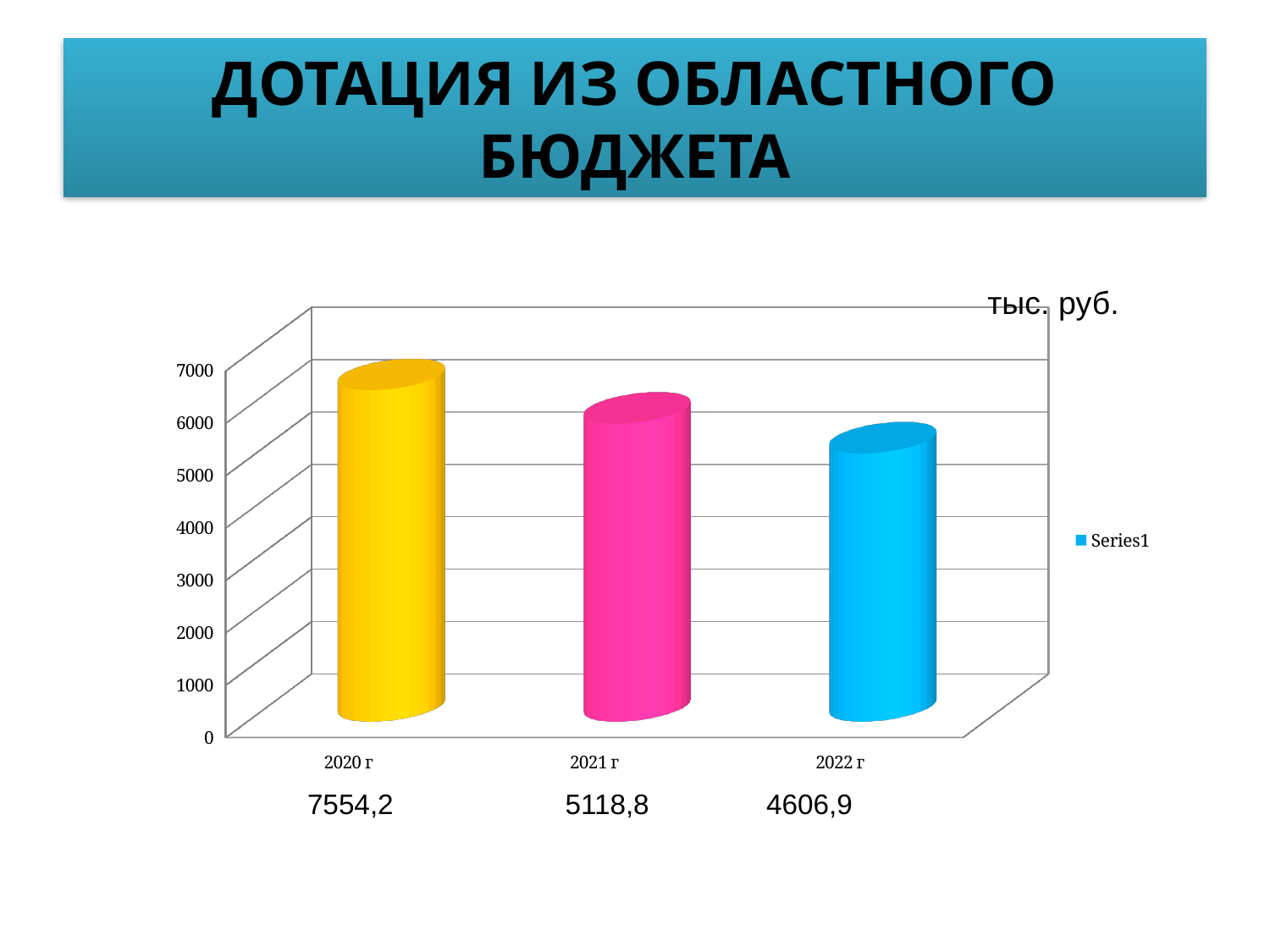
Which year has the lowest value? 2022 г Which is larger, the value for 2020 г or the value for 2022 г? 2020 г How many years are shown on the chart? 3 Do the values rise or fall from 2020 г to 2022 г? fall Is the value for 2022 г greater or less than 3000? greater What kind of chart is shown on the slide? bar chart Which year has the highest value? 2020 г